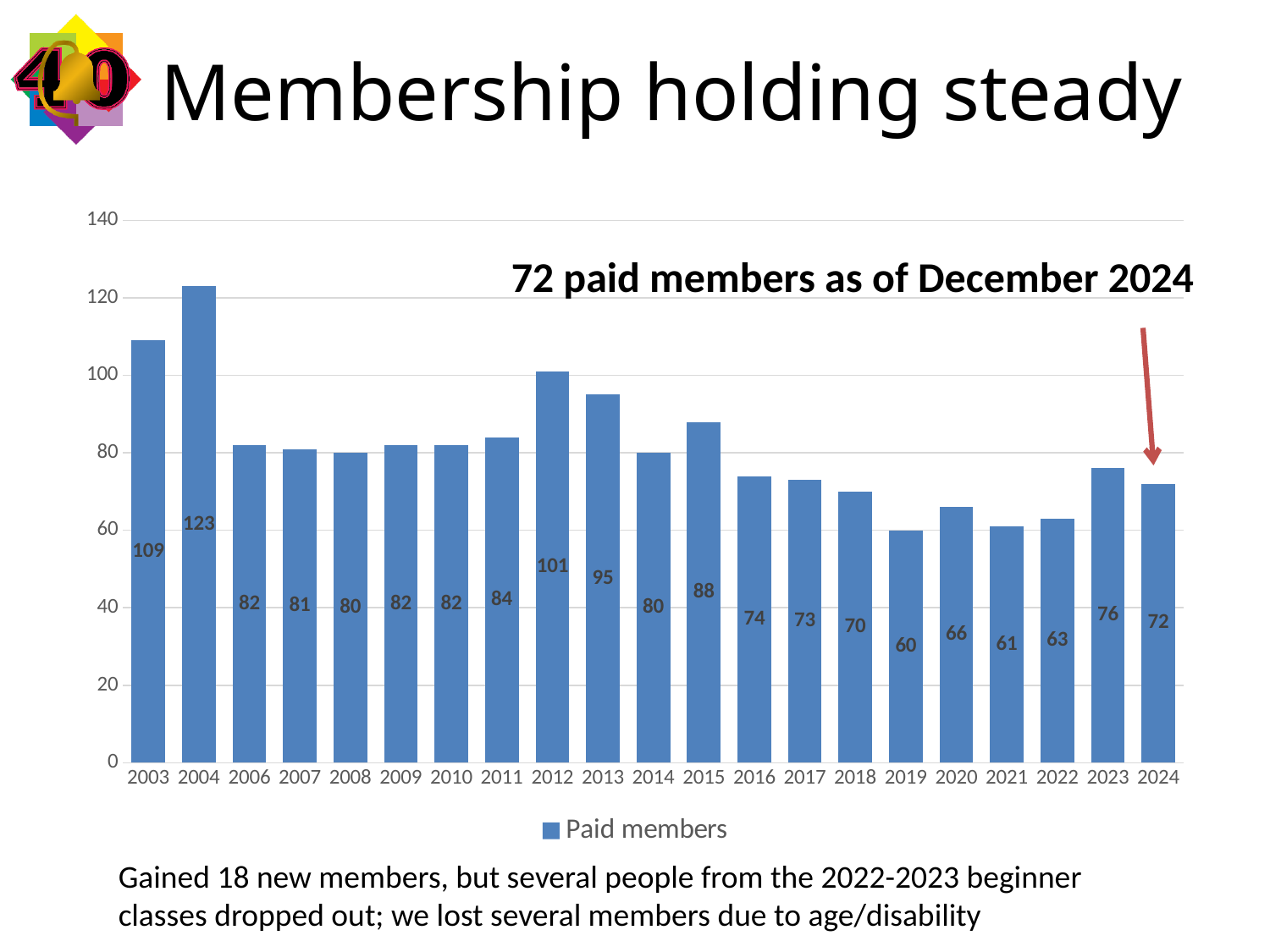
Is the value for 2003 greater or less than 100? greater Which year has the highest number of paid members? 2004 How many paid members were there in 2012? 101 What is the value for paid members in 2019? 60 Which year had more paid members, 2013 or 2015? 2013 What is the name of the series shown in the legend? Paid members How many years are shown on the x axis of the chart? 21 What type of chart is shown on the slide? Bar chart How many series does the legend list? 1 Which year has the lowest number of paid members? 2019 By how much did paid members change from 2023 to 2024? 4 What is the difference in paid members between 2004 and 2024? 51